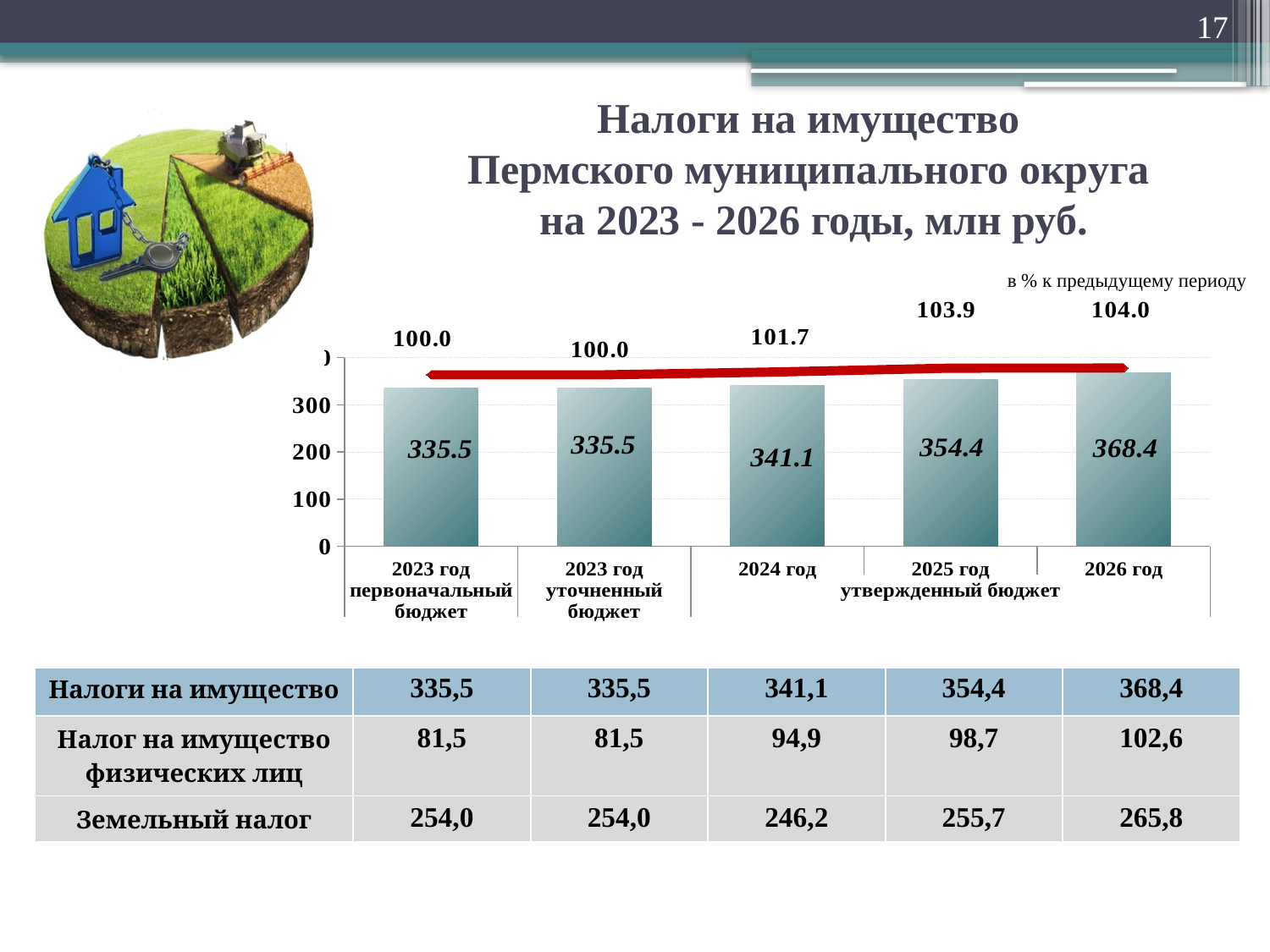
Do the bar values rise or fall from 2024 год to 2026 год? rise What percentage to the previous period is shown above the bar for 2024 год? 101.7 How many bars are plotted in the chart? 5 Which is larger, the bar value for 2025 год or for 2024 год? 2025 год What kind of chart is shown on the slide? combination bar and line chart What is the difference between the bar values for 2026 год and 2025 год? 14.0 What is the value of the bar for 2024 год? 341.1 What is the difference between the bar values for 2024 год and 2023 год уточненный бюджет? 5.6 What is the value of the bar for 2023 год уточненный бюджет? 335.5 What is the value of the bar for 2026 год? 368.4 Which category has the highest bar value? 2026 год What percentage to the previous period is shown above the bar for 2025 год? 103.9